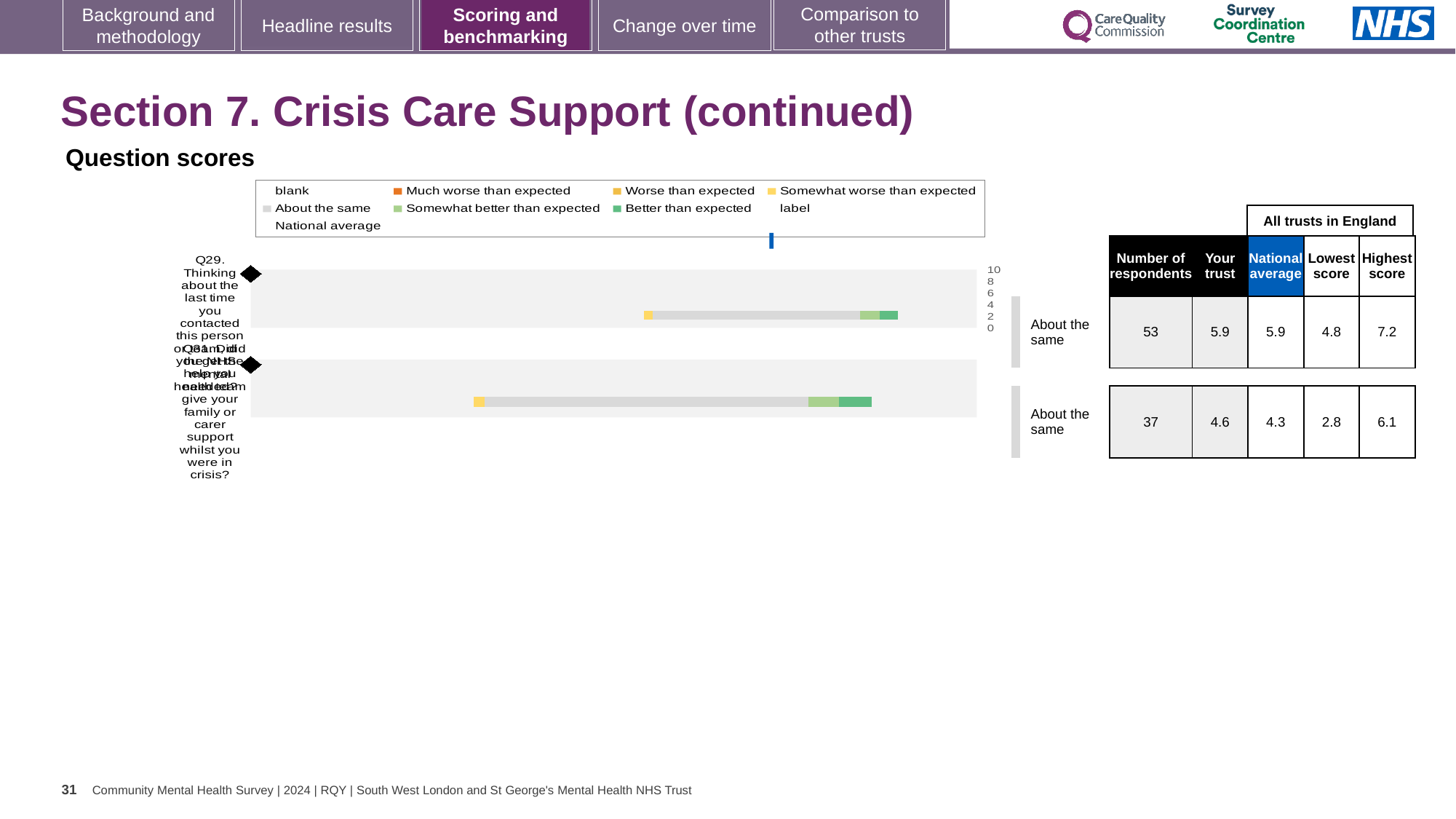
What is the highest value shown on the chart's numeric axis? 10 How many questions are plotted as bars in the chart? 2 What benchmark category is shown for Q31 next to the chart? About the same In the table beside the chart, which question has the higher 'Your trust' score, Q29 or Q31? Q29 What kind of chart is shown under 'Question scores'? bar chart In the table beside the chart, what is the highest score for Q31? 6.1 In the table beside the chart, what is the number of respondents for Q29? 53 In the table beside the chart, what is the difference between the highest and lowest score for Q29? 2.4 In the table beside the chart, what is the difference between the 'Your trust' score and the national average for Q31? 0.3 In the table beside the chart, what is the 'Your trust' score for Q31? 4.6 Which legend entry is shown in orange? Much worse than expected In the table beside the chart, what is the national average for Q29? 5.9